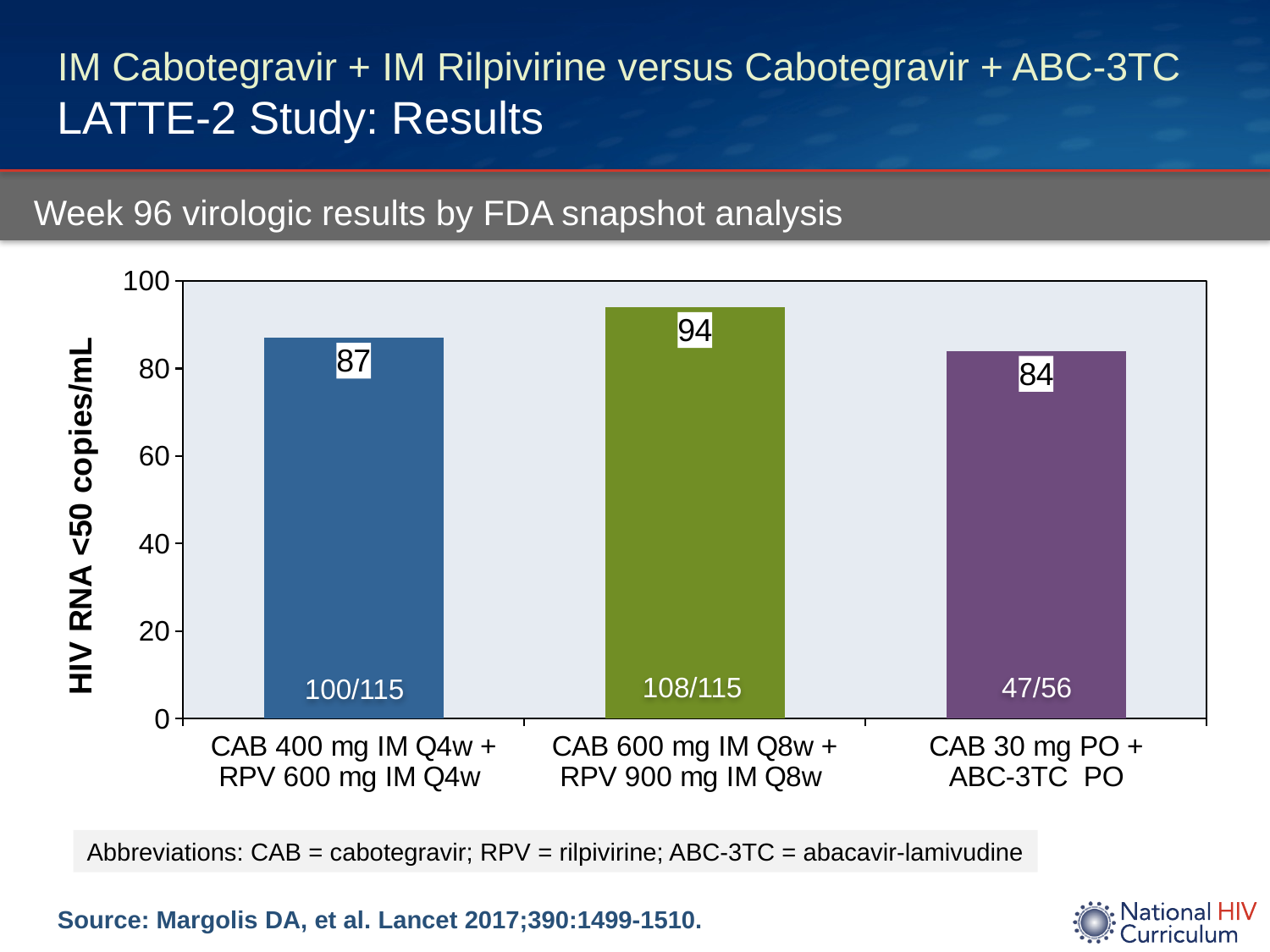
What fraction is printed inside the bar for CAB 600 mg IM Q8w + RPV 900 mg IM Q8w? 108/115 What kind of chart is shown on the slide? Bar chart What is the difference between the values for CAB 600 mg IM Q8w + RPV 900 mg IM Q8w and CAB 30 mg PO + ABC-3TC PO? 10 What is the difference between the values for CAB 600 mg IM Q8w + RPV 900 mg IM Q8w and CAB 400 mg IM Q4w + RPV 600 mg IM Q4w? 7 Which category has the highest value? CAB 600 mg IM Q8w + RPV 900 mg IM Q8w How many categories are shown on the x axis? 3 Which category has the lowest value? CAB 30 mg PO + ABC-3TC PO What is the value for CAB 600 mg IM Q8w + RPV 900 mg IM Q8w? 94 What is the value for CAB 30 mg PO + ABC-3TC PO? 84 What is the value for CAB 400 mg IM Q4w + RPV 600 mg IM Q4w? 87 What is the label of the y axis? HIV RNA <50 copies/mL Which is larger, the value for CAB 400 mg IM Q4w + RPV 600 mg IM Q4w or the value for CAB 30 mg PO + ABC-3TC PO? CAB 400 mg IM Q4w + RPV 600 mg IM Q4w